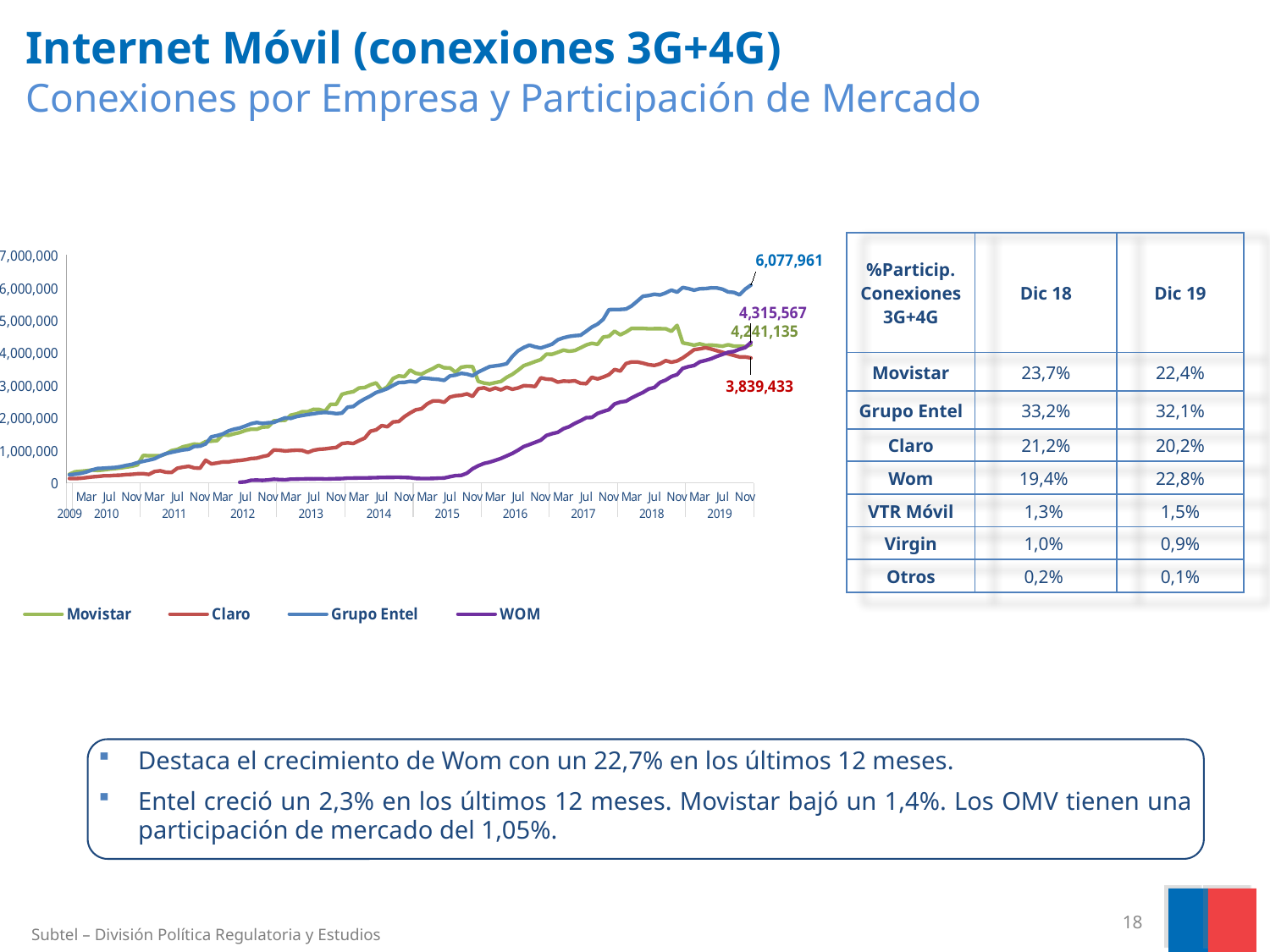
What is the final labelled value for WOM on the chart? 4,315,567 Which series is drawn in purple in the chart legend? WOM How many series does the chart legend list? 4 Which has a larger final labelled value, WOM or Movistar? WOM Does the WOM line generally rise or fall from 2016 to 2019? rise What is the final labelled value for Claro on the chart? 3,839,433 What is the final labelled value for Movistar on the chart? 4,241,135 What is the difference between the final labelled values of Grupo Entel and Claro? 2,238,528 Which series has the lowest final labelled value on the chart? Claro Which series has the highest final labelled value on the chart? Grupo Entel What is the final labelled value for Grupo Entel on the chart? 6,077,961 What type of chart is shown on the slide? line chart